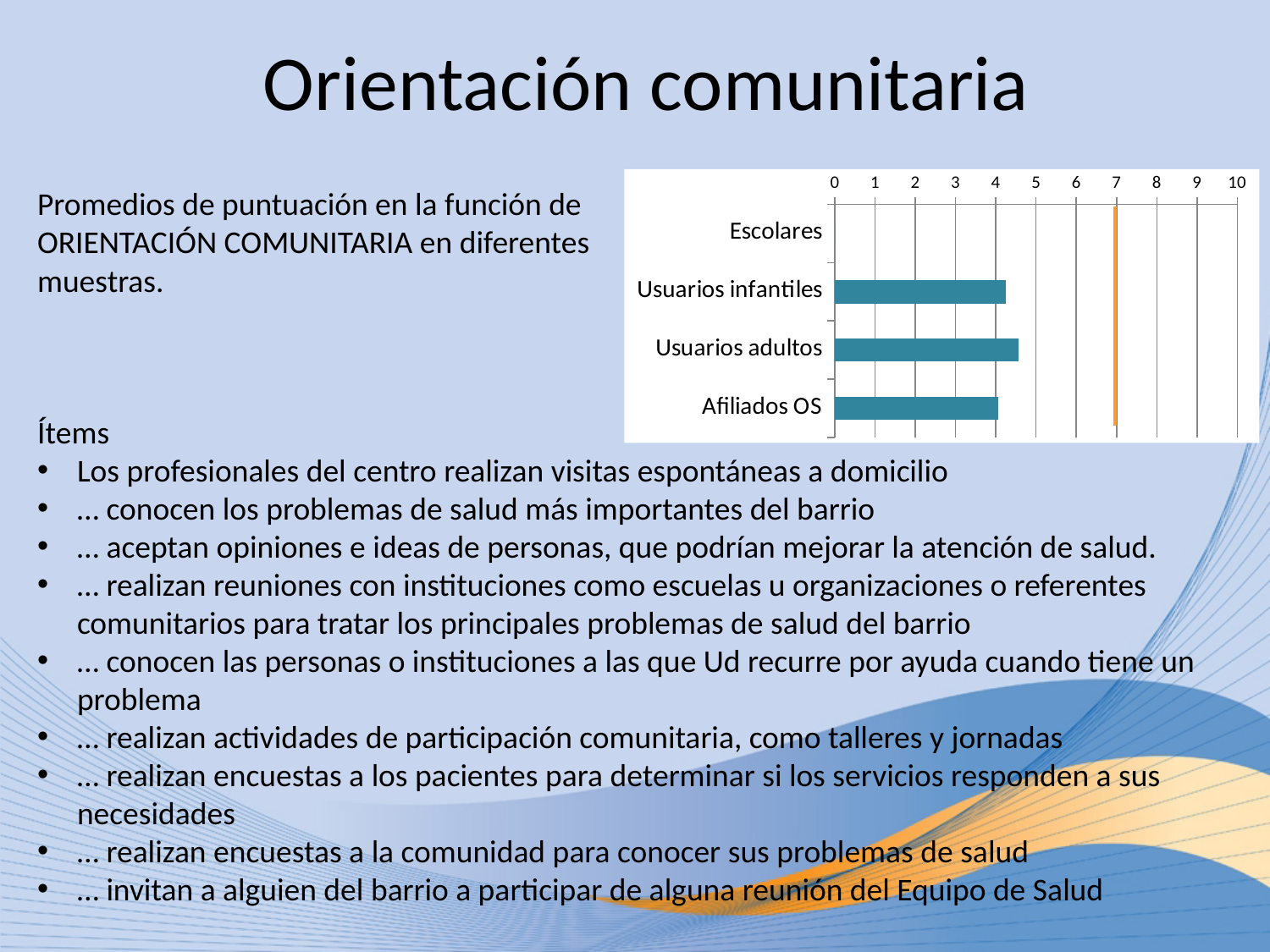
Which category in the chart has no bar plotted? Escolares What is the maximum value shown on the horizontal axis of the chart? 10 What kind of chart is shown on the slide? bar chart Is the value for Afiliados OS greater or less than 3? greater Is the value for Usuarios infantiles greater or less than 5? less Is the value for Usuarios infantiles greater or less than 7? less How many categories are listed on the vertical axis of the chart? 4 Which is larger, the value for Usuarios adultos or the value for Afiliados OS? Usuarios adultos Which category has the longest bar in the chart? Usuarios adultos